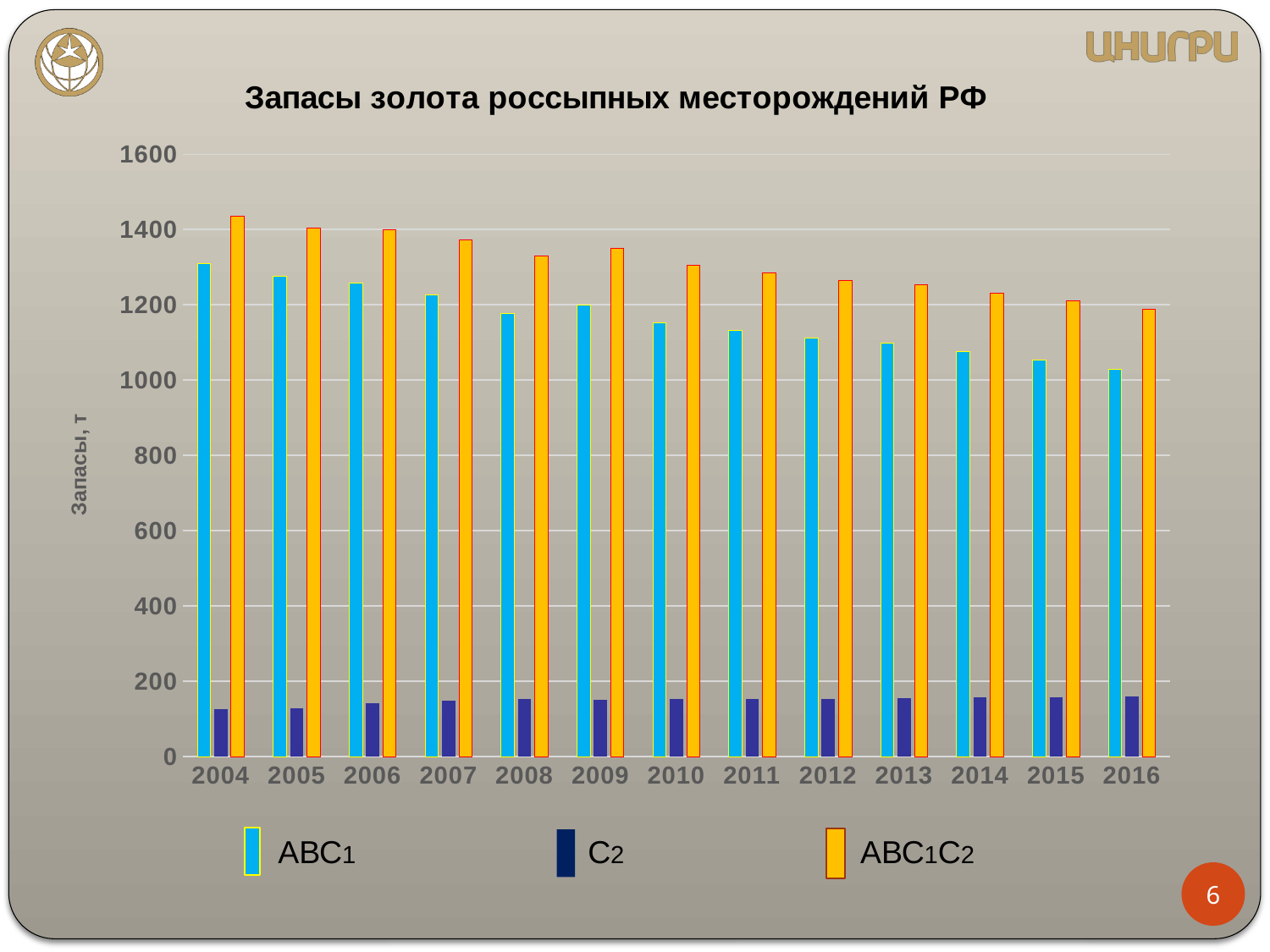
What kind of chart is shown on the slide? bar chart Which year has the larger ABC1 value, 2005 or 2010? 2005 How many years are shown along the x axis? 13 Do the ABC1C2 values generally rise or fall from 2004 to 2016? fall Is the C2 value for 2010 greater or less than 200? less What is the title of the chart? Запасы золота россыпных месторождений РФ Is the ABC1 value for 2004 greater or less than 1200? greater Is the ABC1 value for 2016 greater or less than 1200? less In which year is the ABC1 value lowest? 2016 How many series does the legend list? 3 In which year is the ABC1C2 value highest? 2004